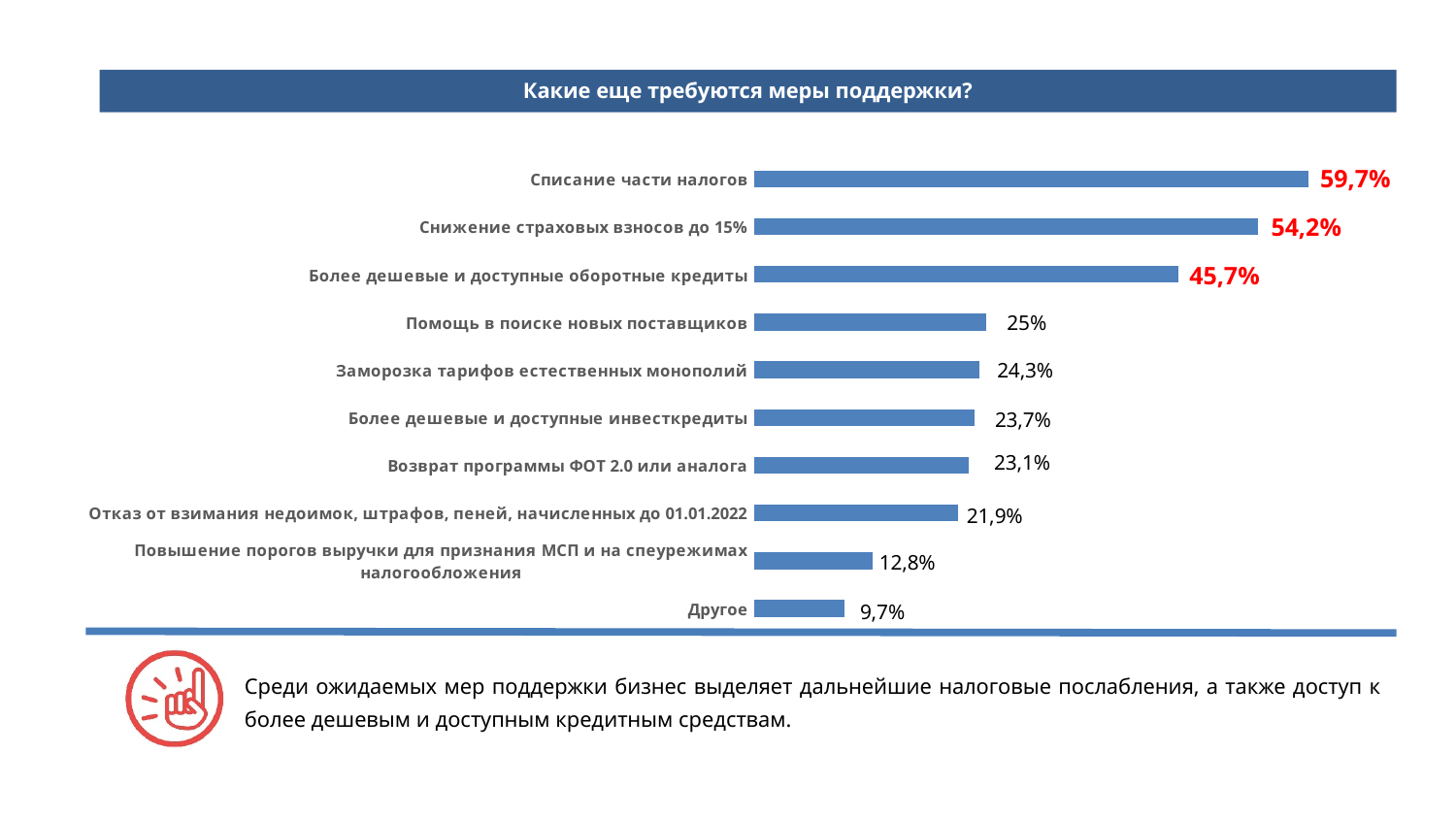
What is the title of the chart? Какие еще требуются меры поддержки? What is the difference between «Более дешевые и доступные оборотные кредиты» and «Другое»? 36% How many categories are shown in the chart? 10 What is the value for «Помощь в поиске новых поставщиков»? 25% Which is larger: «Заморозка тарифов естественных монополий» or «Возврат программы ФОТ 2.0 или аналога»? Заморозка тарифов естественных монополий What is the value for «Списание части налогов»? 59,7% What is the value for «Повышение порогов выручки для признания МСП и на спецрежимах налогообложения»? 12,8% How many data labels are highlighted in red? 3 What is the difference between «Списание части налогов» and «Снижение страховых взносов до 15%»? 5,5% What kind of chart is shown on the slide? Bar chart Which category has the lowest value? Другое Which category has the highest value? Списание части налогов